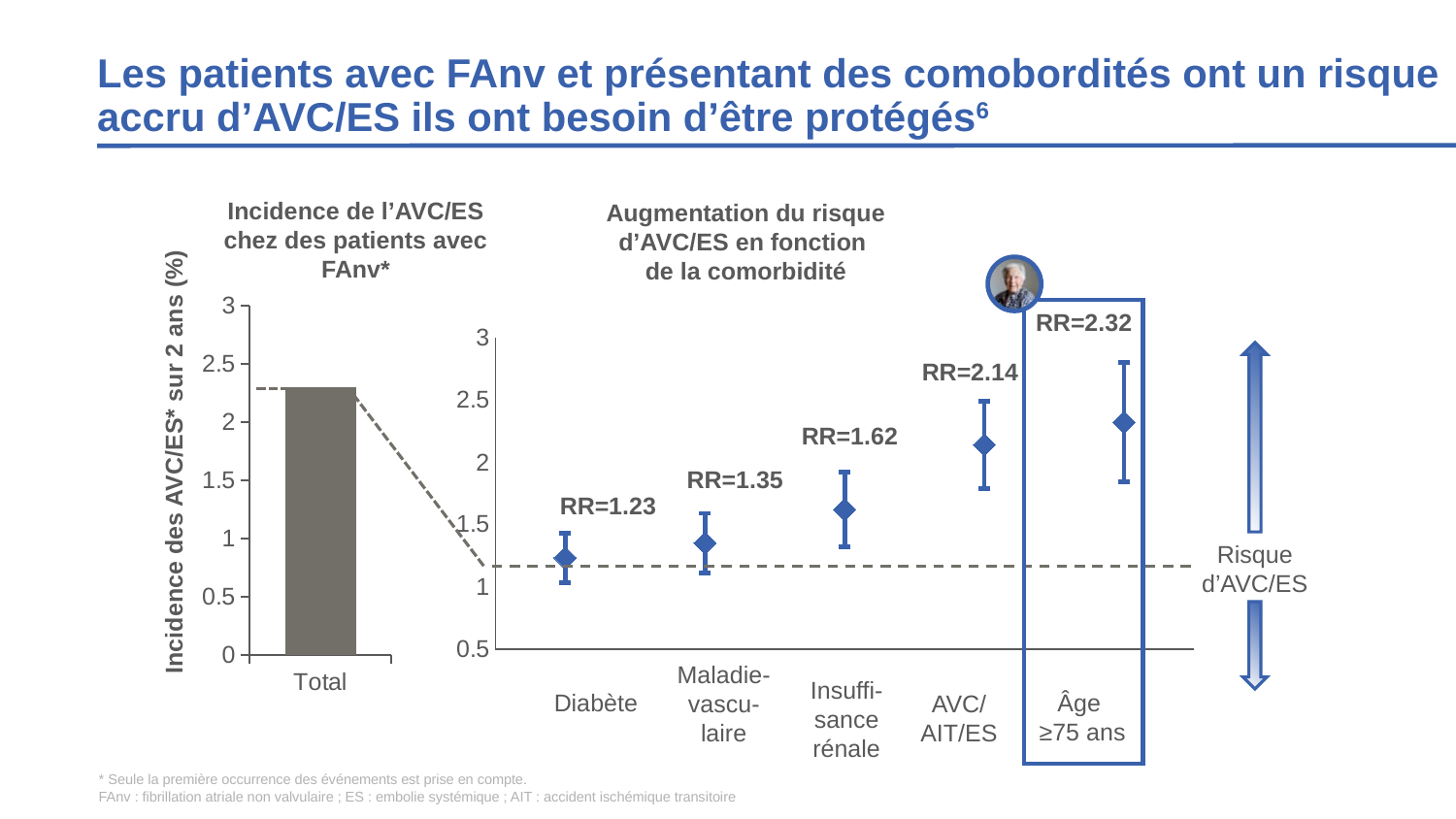
In the chart titled 'Augmentation du risque d'AVC/ES en fonction de la comorbidité', do the RR values rise or fall from left to right along the x axis? rise In the chart titled 'Augmentation du risque d'AVC/ES en fonction de la comorbidité', which comorbidity has the highest RR? Âge ≥75 ans What kind of chart is the chart titled 'Incidence de l'AVC/ES chez des patients avec FAnv*'? bar chart In the chart titled 'Augmentation du risque d'AVC/ES en fonction de la comorbidité', what is the RR value for Diabète? RR=1.23 In the chart titled 'Augmentation du risque d'AVC/ES en fonction de la comorbidité', what is the difference between the RR for Âge ≥75 ans and the RR for Diabète? 1.09 In the chart titled 'Augmentation du risque d'AVC/ES en fonction de la comorbidité', how many comorbidity categories are shown on the x axis? 5 In the chart titled 'Augmentation du risque d'AVC/ES en fonction de la comorbidité', which has a larger RR: Maladie vasculaire or AVC/AIT/ES? AVC/AIT/ES In the chart titled 'Incidence de l'AVC/ES chez des patients avec FAnv*', is the value for Total greater or less than 2? greater In the chart titled 'Augmentation du risque d'AVC/ES en fonction de la comorbidité', what is the RR value for Âge ≥75 ans? RR=2.32 In the chart titled 'Augmentation du risque d'AVC/ES en fonction de la comorbidité', which comorbidity has the lowest RR? Diabète In the chart titled 'Augmentation du risque d'AVC/ES en fonction de la comorbidité', what is the RR value for Insuffisance rénale? RR=1.62 In the chart titled 'Augmentation du risque d'AVC/ES en fonction de la comorbidité', what is the difference between the RR for AVC/AIT/ES and the RR for Insuffisance rénale? 0.52